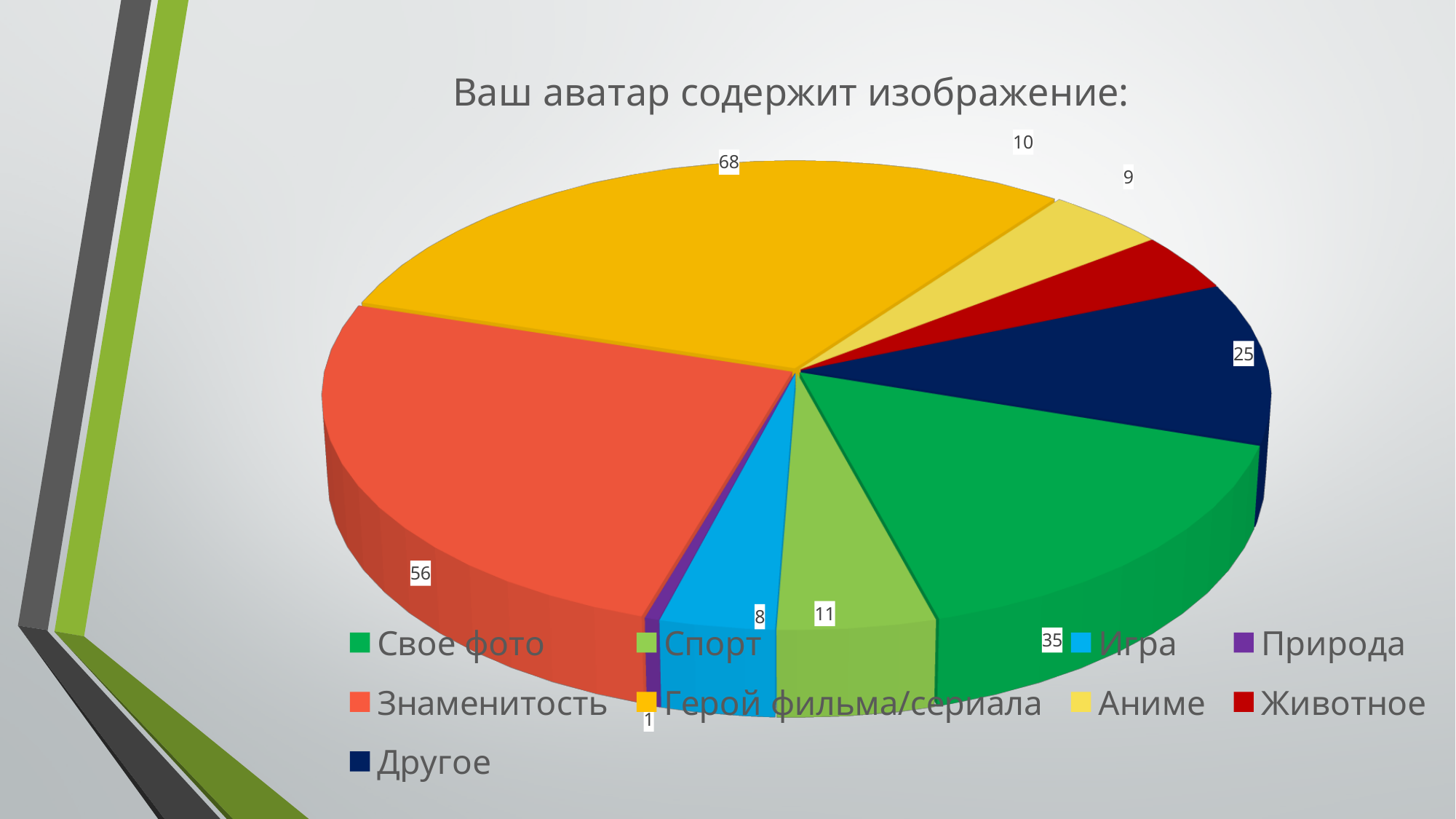
What is the difference between the values for Герой фильма/сериала and Знаменитость? 12 What is the value for Герой фильма/сериала? 68 What is the value for Знаменитость? 56 Which category has the largest slice? Герой фильма/сериала What kind of chart is shown on the slide? pie chart What is the value for Свое фото? 35 Which category has the smallest slice? Природа What is the title of the chart? Ваш аватар содержит изображение: What is the value for Природа? 1 Which is larger, the value for Другое or the value for Спорт? Другое How many categories does the pie chart have? 9 What is the value for Другое? 25